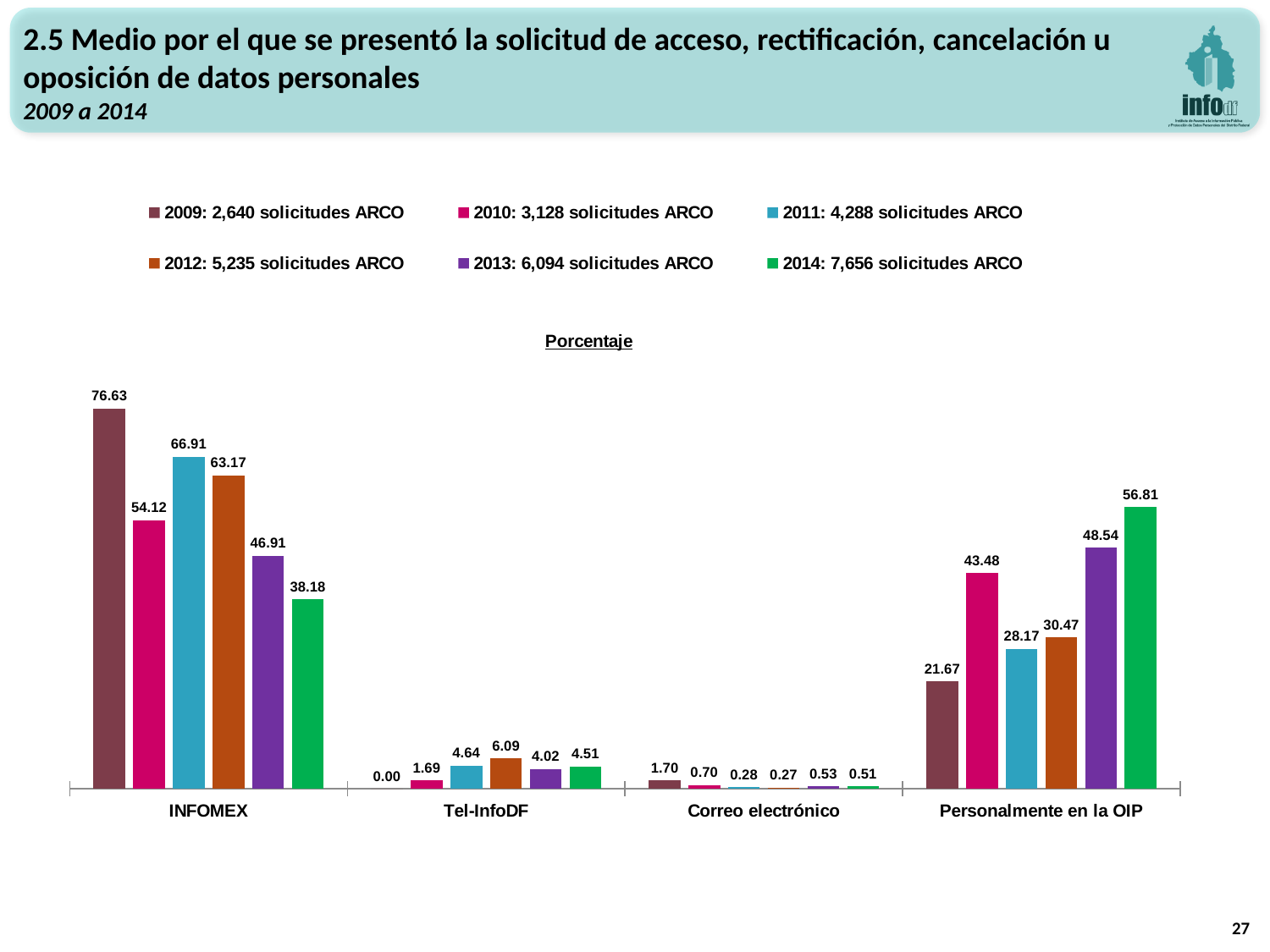
What is the value for Tel-InfoDF in the 2012 series? 6.09 What is the value for Personalmente en la OIP in the 2014 series? 56.81 Which category has the highest value in the 2014 series? Personalmente en la OIP According to the legend, how many solicitudes ARCO were there in 2014? 7,656 Which category has the lowest value in the 2009 series? Tel-InfoDF What is the value for INFOMEX in the 2009 series? 76.63 What is the difference between the 2009 and 2014 values for INFOMEX? 38.45 What kind of chart is shown on the slide? Bar chart How many categories are shown on the x axis? 4 How many series does the legend list? 6 What is the value for Correo electrónico in the 2010 series? 0.70 Which is larger for Personalmente en la OIP: the 2010 value or the 2011 value? 2010